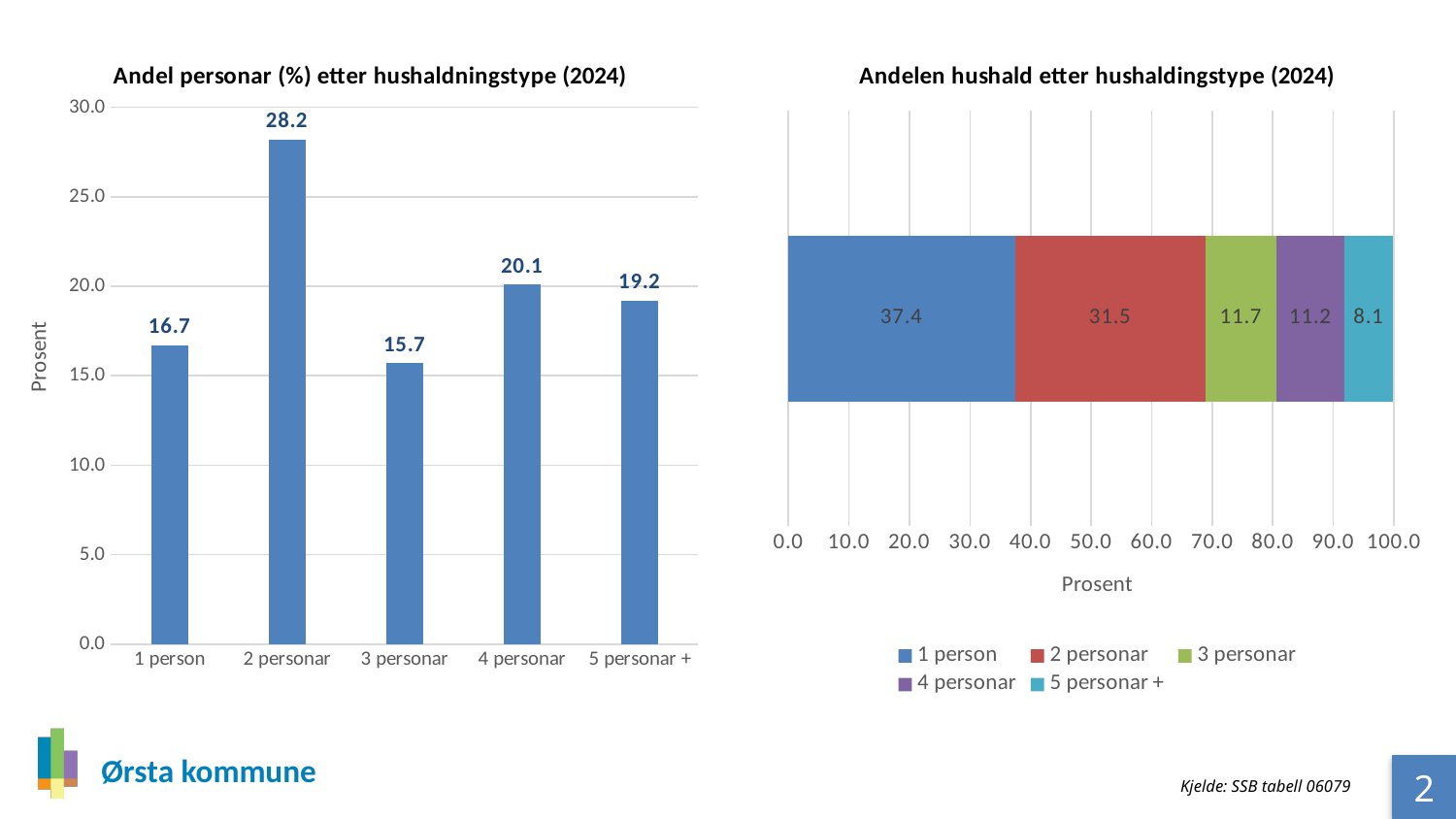
In the chart 'Andelen hushald etter hushaldingstype (2024)', what is the total of the stacked bar? 99.9 In the chart 'Andelen hushald etter hushaldingstype (2024)', how many series does the legend list? 5 In the chart 'Andel personar (%) etter hushaldningstype (2024)', what is the difference between the values for 2 personar and 1 person? 11.5 In the chart 'Andel personar (%) etter hushaldningstype (2024)', is the value for 4 personar greater or less than 20.0? greater In the chart 'Andel personar (%) etter hushaldningstype (2024)', how many categories are shown on the x axis? 5 In the chart 'Andel personar (%) etter hushaldningstype (2024)', what is the value for 2 personar? 28.2 In the chart 'Andel personar (%) etter hushaldningstype (2024)', which category has the highest value? 2 personar What kind of chart is 'Andelen hushald etter hushaldingstype (2024)'? Stacked bar chart In the chart 'Andelen hushald etter hushaldingstype (2024)', which is larger, the value for 3 personar or the value for 4 personar? 3 personar In the chart 'Andel personar (%) etter hushaldningstype (2024)', which category has the lowest value? 3 personar In the chart 'Andelen hushald etter hushaldingstype (2024)', what is the value for 5 personar +? 8.1 In the chart 'Andelen hushald etter hushaldingstype (2024)', what is the value for 1 person? 37.4